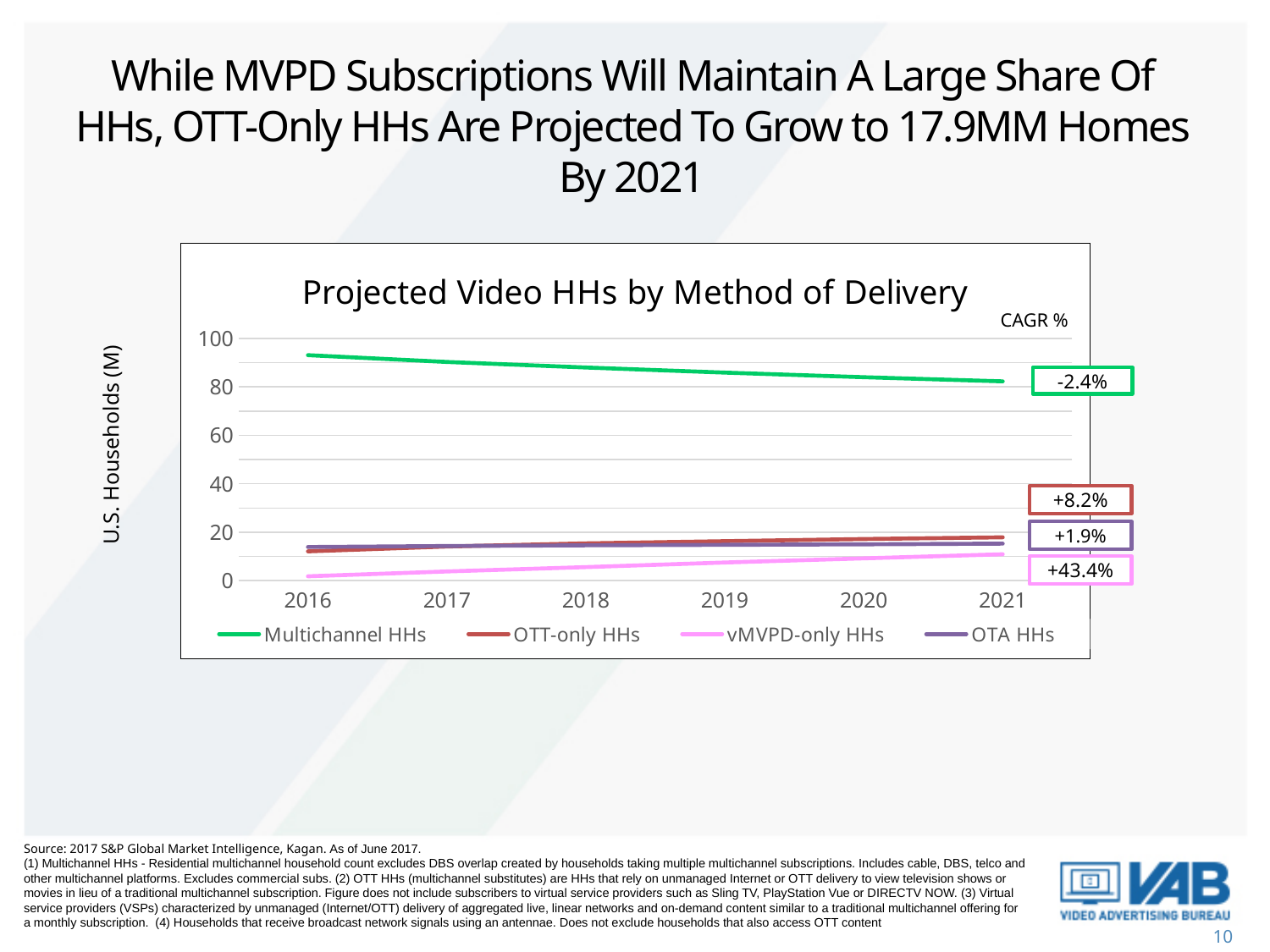
How many series does the chart legend list? 4 Is the value for Multichannel HHs in 2016 greater or less than 80? greater Which series has the highest values across all years in the chart? Multichannel HHs Does the Multichannel HHs line rise or fall from 2016 to 2021? Fall Which series has the lowest value in 2016? vMVPD-only HHs What is the title of the chart? Projected Video HHs by Method of Delivery Does the vMVPD-only HHs line rise or fall from 2016 to 2021? Rise How many years are shown on the x axis of the chart? 6 Is the value for OTT-only HHs in 2021 greater or less than 40? less What type of chart is shown on the slide? Line chart What CAGR % is shown for vMVPD-only HHs? +43.4% What CAGR % is shown for Multichannel HHs? -2.4%